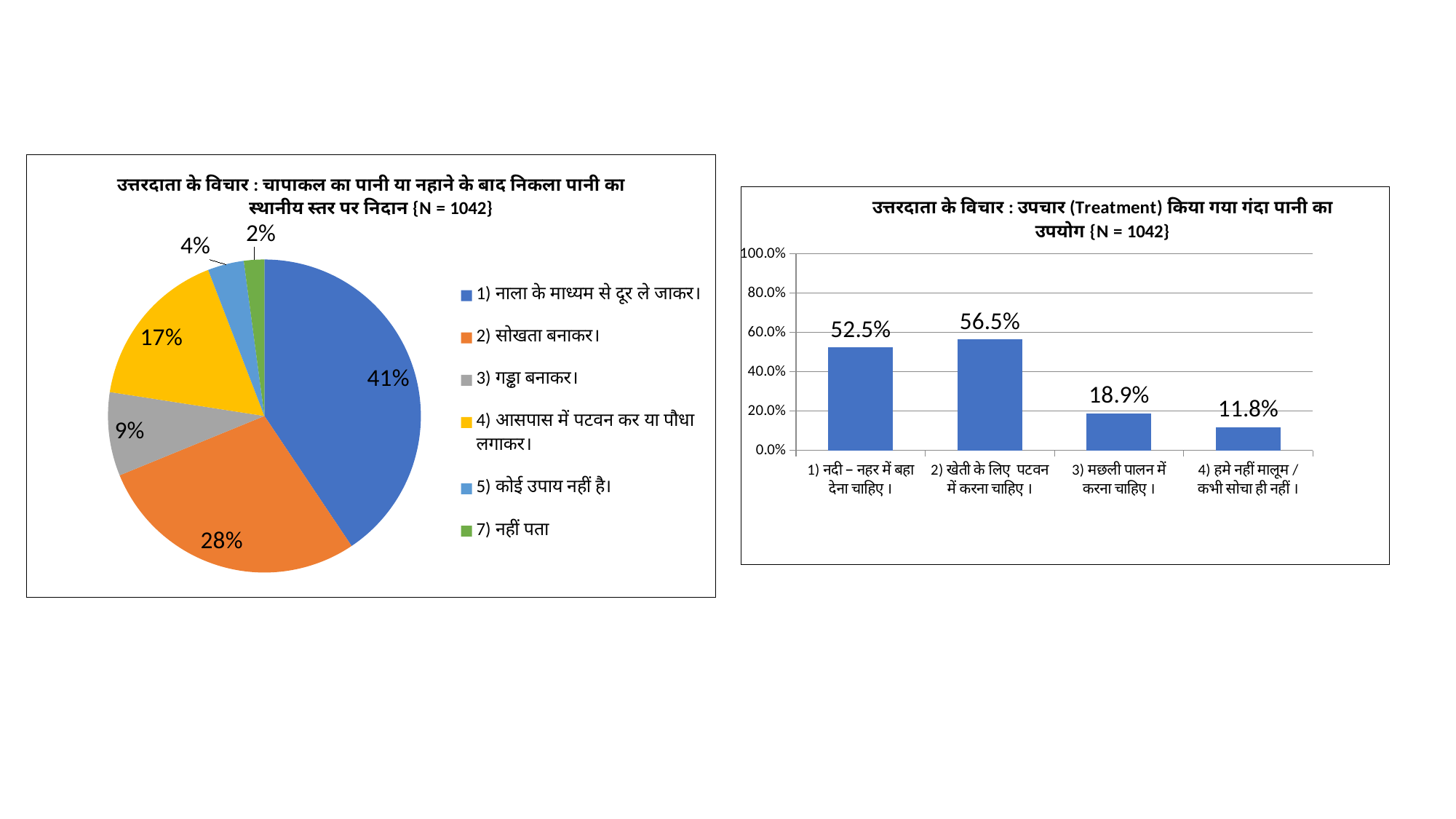
In the pie chart on the left, how many categories does the legend list? 6 In the pie chart on the left, what share is shown for '4) आसपास में पटवन कर या पौधा लगाकर।'? 17% In the bar chart on the right, what is the value for '2) खेती के लिए पटवन में करना चाहिए ।'? 56.5% In the pie chart on the left, what share is shown for '1) नाला के माध्यम से दूर ले जाकर।'? 41% In the pie chart on the left, what is the difference between the shares for '3) गड्ढा बनाकर।' and '5) कोई उपाय नहीं है।'? 5% In the pie chart on the left, what share is shown for '2) सोखता बनाकर।'? 28% What kind of chart is the chart on the right? bar chart In the bar chart on the right, which category has the highest value? 2) खेती के लिए पटवन में करना चाहिए । In the bar chart on the right, what is the difference between the values for '1) नदी – नहर में बहा देना चाहिए ।' and '3) मछली पालन में करना चाहिए ।'? 33.6% In the pie chart on the left, which category has the smallest slice? 7) नहीं पता In the bar chart on the right, what is the value for '4) हमे नहीं मालूम / कभी सोचा ही नहीं ।'? 11.8% In the bar chart on the right, how many bars are plotted? 4